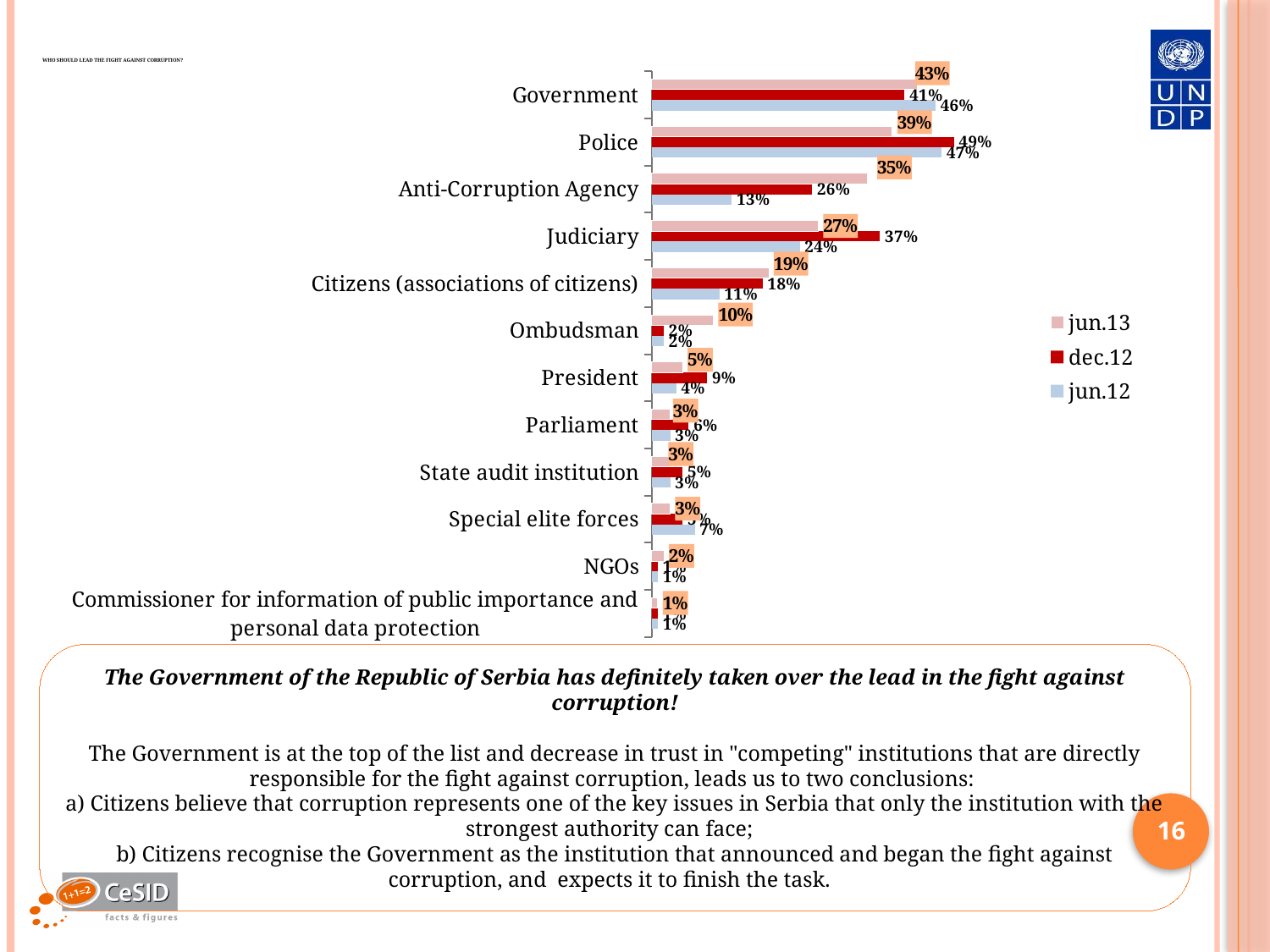
What is the jun.13 value for Government? 43% What is the jun.12 value for Anti-Corruption Agency? 13% What is the jun.13 value for Ombudsman? 10% What is the dec.12 value for Police? 49% Which category has the highest dec.12 value? Police Which category has the highest jun.13 value? Government By how many percentage points does the jun.13 value for Anti-Corruption Agency exceed its jun.12 value? 22 percentage points What kind of chart is shown on the slide? Bar chart How many series does the legend list? 3 For Judiciary, which is larger: the dec.12 value or the jun.13 value? dec.12 What are the three entries in the chart legend? jun.13, dec.12, jun.12 How many categories are shown on the chart? 12